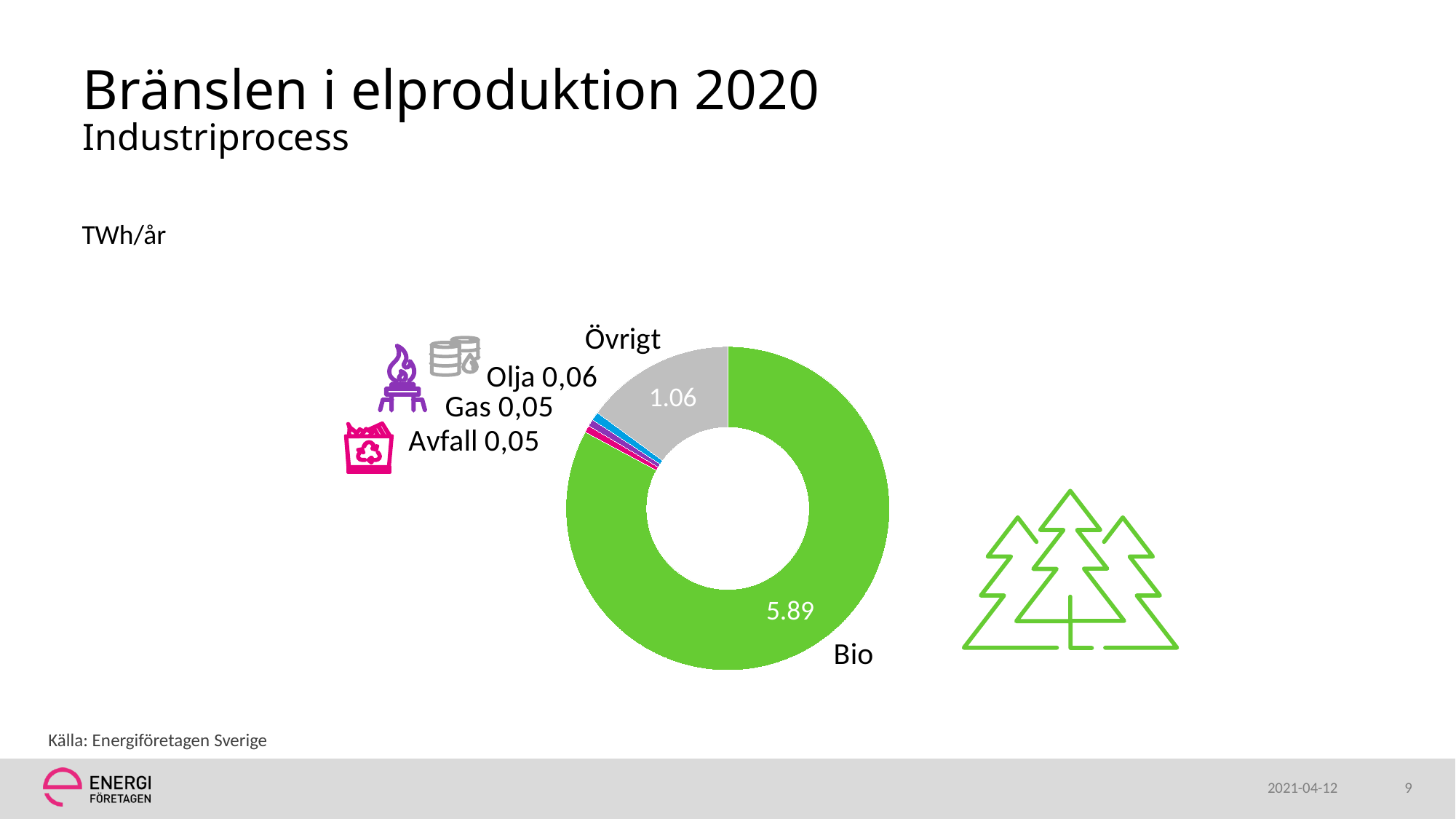
How many categories are shown in the chart? 5 What kind of chart is shown on the slide? Donut (pie) chart What is the value for Olja in the chart? 0,06 What is the title of the slide containing the chart? Bränslen i elproduktion 2020 What is the value for Bio in the chart? 5.89 What is the value for Avfall in the chart? 0,05 What is the difference between the values for Bio and Övrigt? 4.83 What is the value for Gas in the chart? 0,05 What unit is given for the values in the chart? TWh/år Which is larger, the value for Övrigt or the value for Olja? Övrigt Which category has the largest share of the chart? Bio What is the value for Övrigt in the chart? 1.06